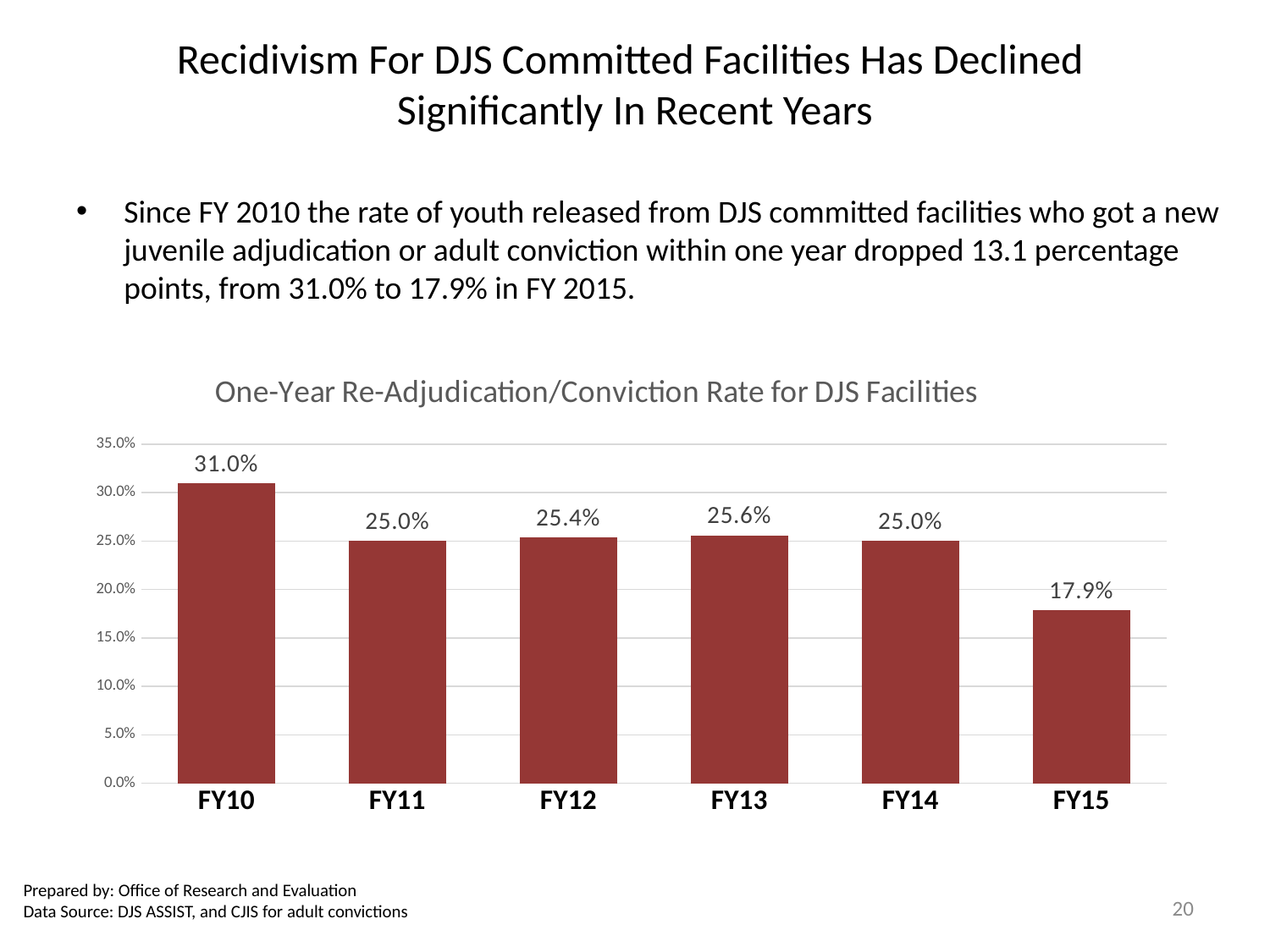
Which fiscal year has the lowest re-adjudication/conviction rate? FY15 Which fiscal year has the highest re-adjudication/conviction rate? FY10 Which is larger, the value for FY10 or the value for FY14? FY10 Is the value for FY15 greater or less than 20.0%? less What is the title of the chart? One-Year Re-Adjudication/Conviction Rate for DJS Facilities How many fiscal years are shown on the chart? 6 By how many percentage points did the rate drop from FY10 to FY15? 13.1 What kind of chart is shown on the slide? Bar chart What is the value shown for FY13? 25.6% What is the one-year re-adjudication/conviction rate for FY15? 17.9% What is the difference between the FY13 value and the FY12 value? 0.2 percentage points What is the one-year re-adjudication/conviction rate for FY10? 31.0%